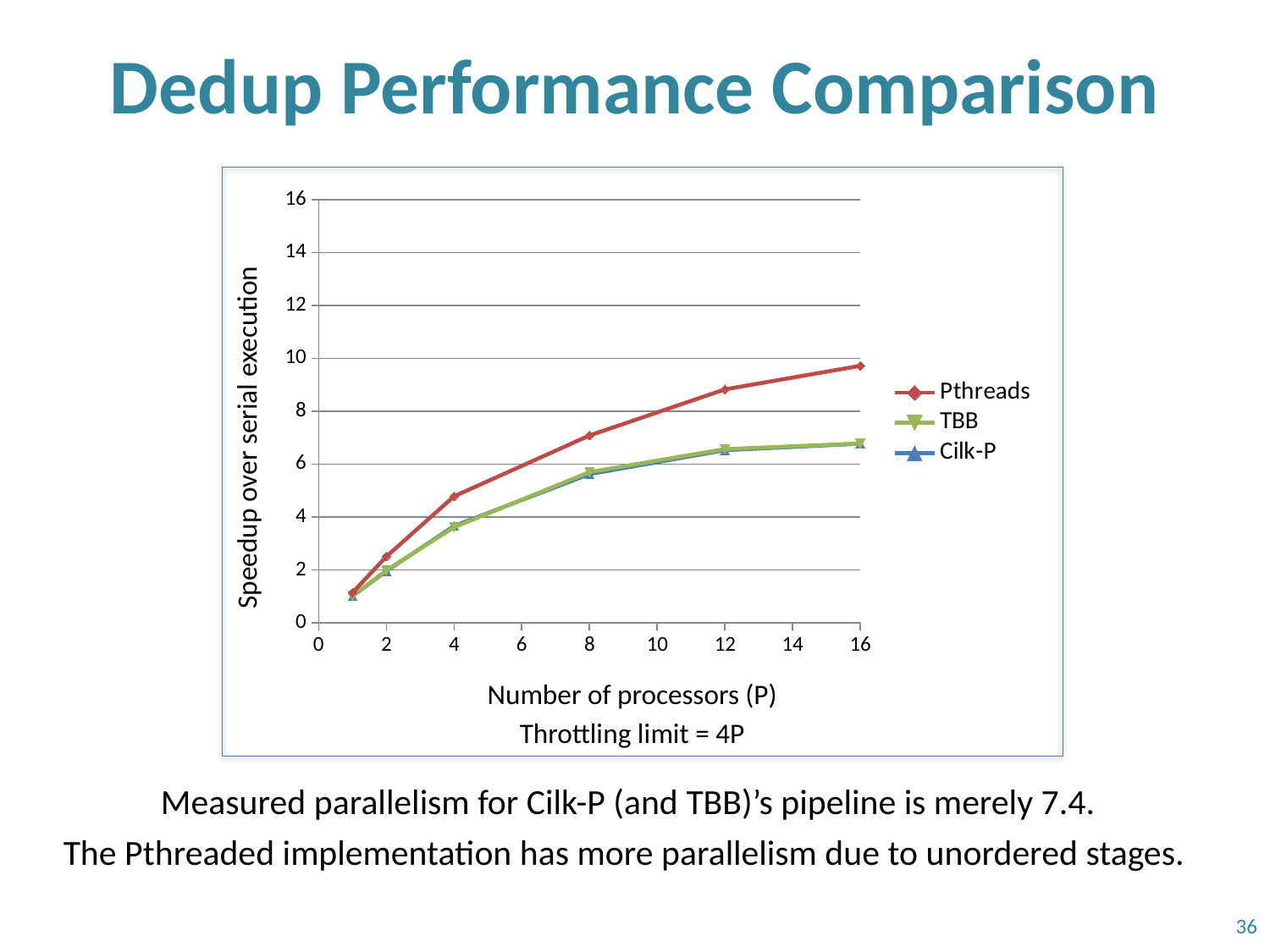
Is the speedup for Pthreads at 4 processors greater or less than 4? greater How many data points are plotted for the Pthreads series? 6 Which series has the highest speedup at 16 processors? Pthreads Is the speedup for Pthreads at 16 processors greater or less than 8? greater What kind of chart is shown on the slide? line chart Does the speedup for Pthreads rise or fall as the number of processors increases? rise Is the speedup for TBB at 16 processors greater or less than 8? less At 8 processors, which has the larger speedup, Pthreads or TBB? Pthreads What is the label of the y axis? Speedup over serial execution How many series does the legend list? 3 Which series are listed in the legend? Pthreads, TBB, Cilk-P